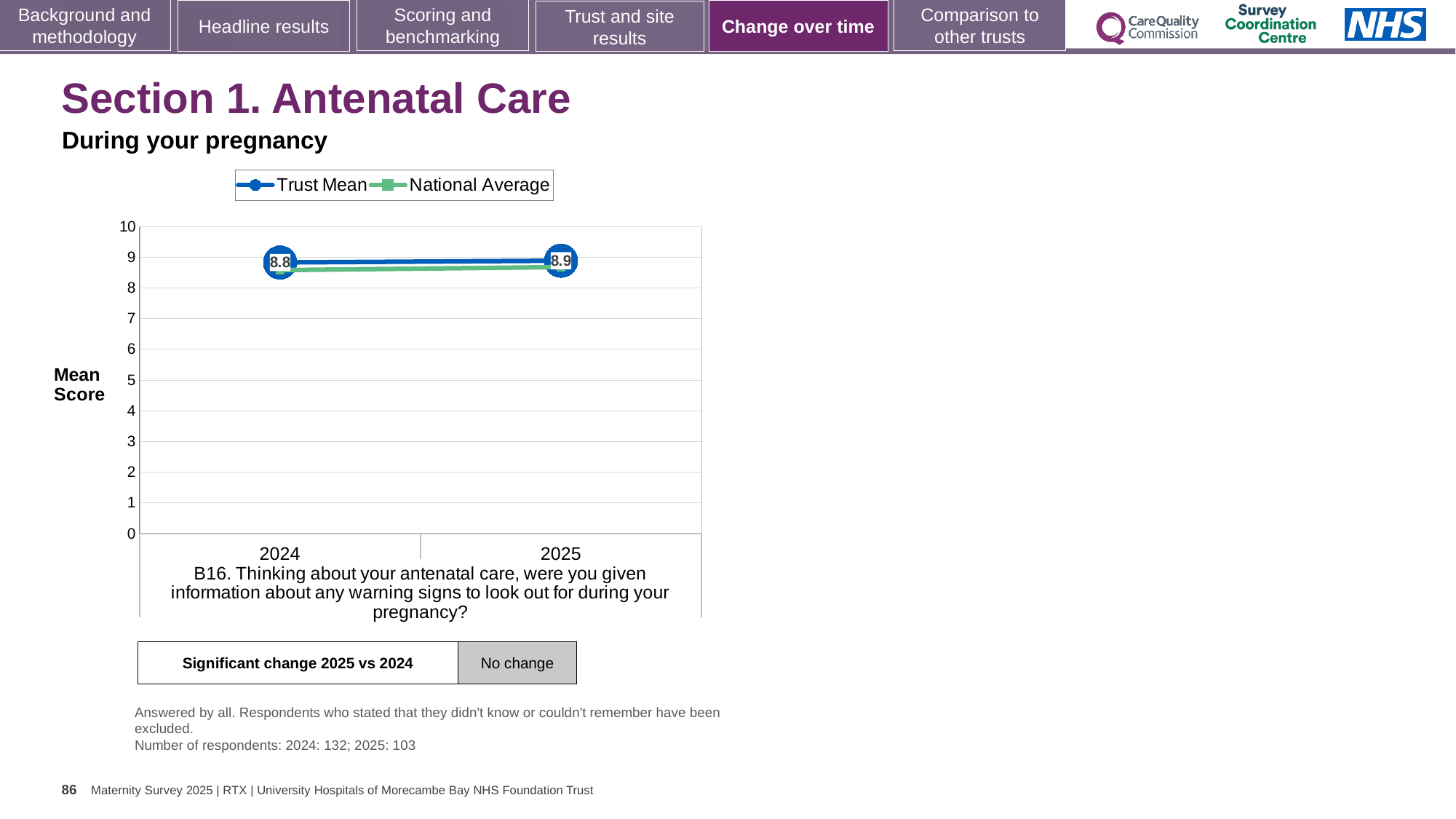
In which year is the Trust Mean higher, 2024 or 2025? 2025 Does the Trust Mean rise or fall from 2024 to 2025? rise Is the National Average value for 2024 greater or less than 8? greater How many years are plotted on the x axis? 2 How many series does the legend list? 2 By how much did the Trust Mean change from 2024 to 2025? 0.1 What is the Trust Mean score for 2024? 8.8 What is the Trust Mean score for 2025? 8.9 Is the National Average value for 2025 greater or less than 9? less Which series is shown in green in the legend? National Average What is the label of the y axis? Mean Score What kind of chart is shown on the slide? line chart